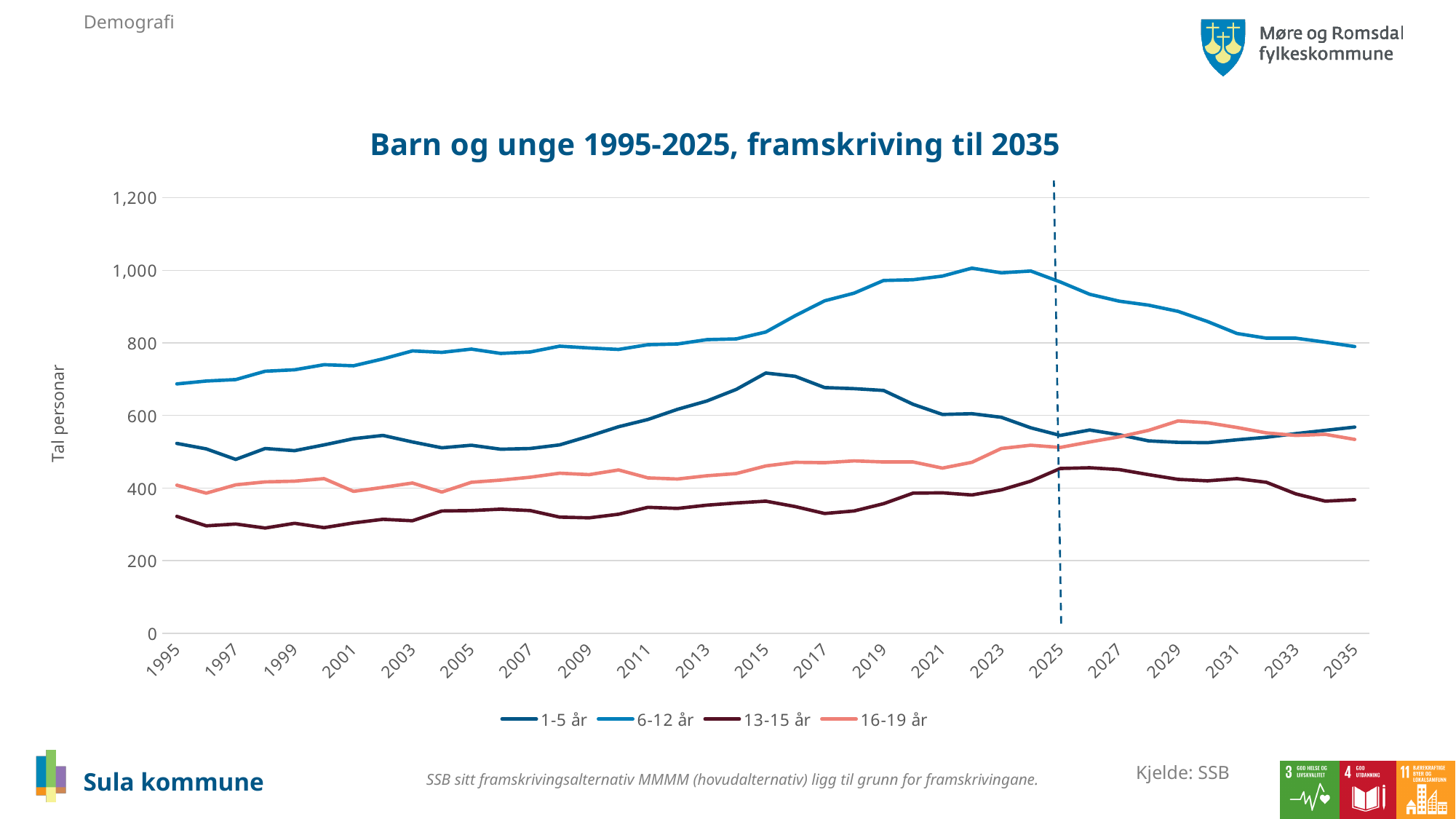
Does the 6-12 år series rise or fall from 2025 to 2035? fall Is the value for 16-19 år in 2029 greater or less than 400? greater What kind of chart is shown on the slide? line chart What are the series names listed in the legend? 1-5 år, 6-12 år, 13-15 år, 16-19 år Which series has the lowest value in 1995? 13-15 år Which series has the highest values across the whole period? 6-12 år How many series does the legend list? 4 Is the value for 6-12 år in 2017 greater or less than 800? greater Is the value for 1-5 år in 2015 greater or less than 600? greater In 2035, which is larger: the value for 6-12 år or the value for 1-5 år? 6-12 år What is the title of the chart? Barn og unge 1995-2025, framskriving til 2035